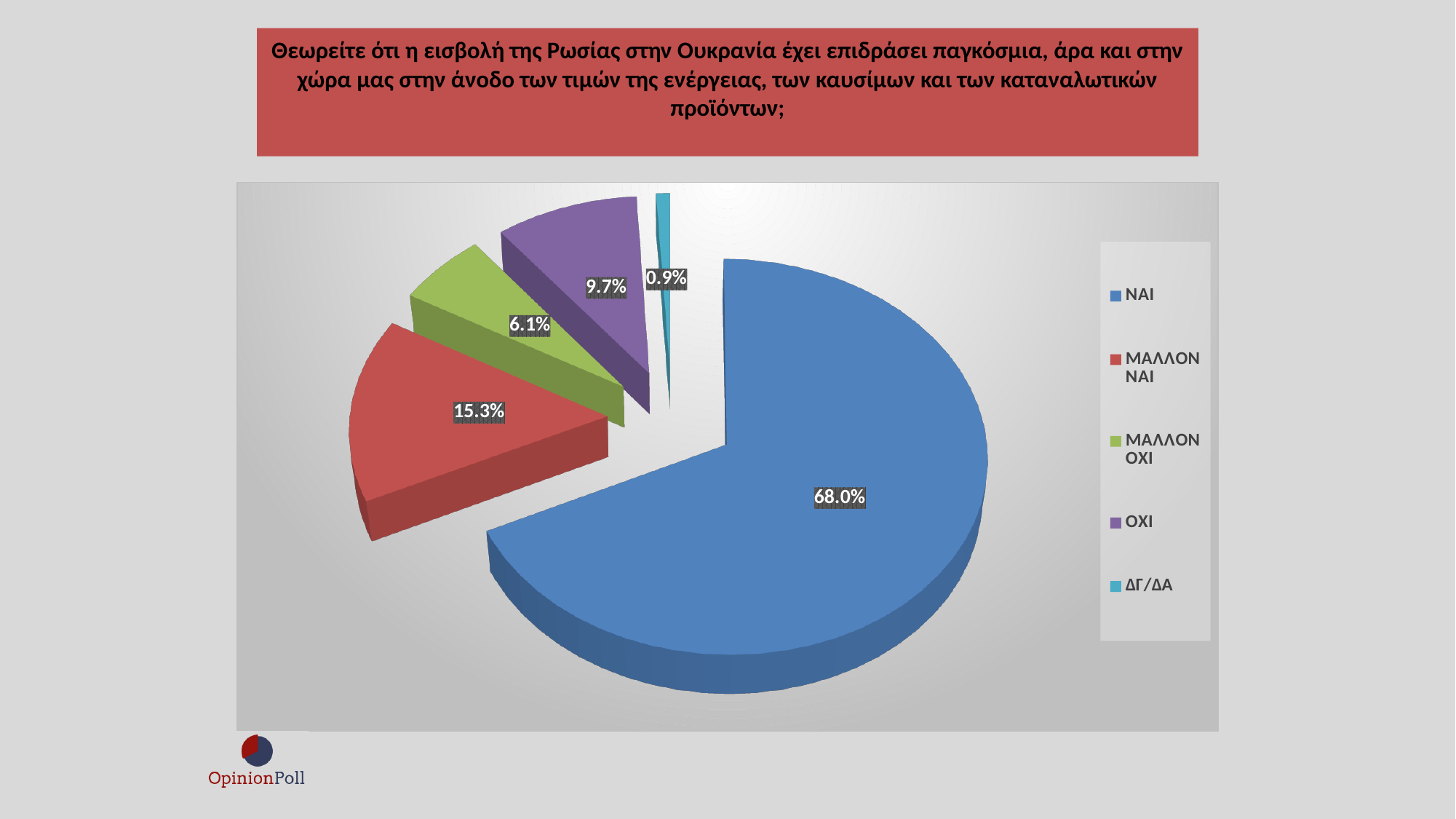
Which response has the largest share of the pie? ΝΑΙ What type of chart is shown on the slide? Pie chart Which response has the smallest share of the pie? ΔΓ/ΔΑ How many categories does the legend list? 5 What percentage of respondents answered ΔΓ/ΔΑ? 0.9% What percentage of respondents answered ΜΑΛΛΟΝ ΝΑΙ? 15.3% What percentage of respondents answered ΝΑΙ? 68.0% What is the difference in percentage points between ΝΑΙ and ΜΑΛΛΟΝ ΝΑΙ? 52.7 What percentage of respondents answered ΜΑΛΛΟΝ ΟΧΙ? 6.1% What percentage of respondents answered ΟΧΙ? 9.7% What colour is the slice for ΜΑΛΛΟΝ ΝΑΙ? Red Which is larger, the share for ΟΧΙ or the share for ΜΑΛΛΟΝ ΟΧΙ? ΟΧΙ